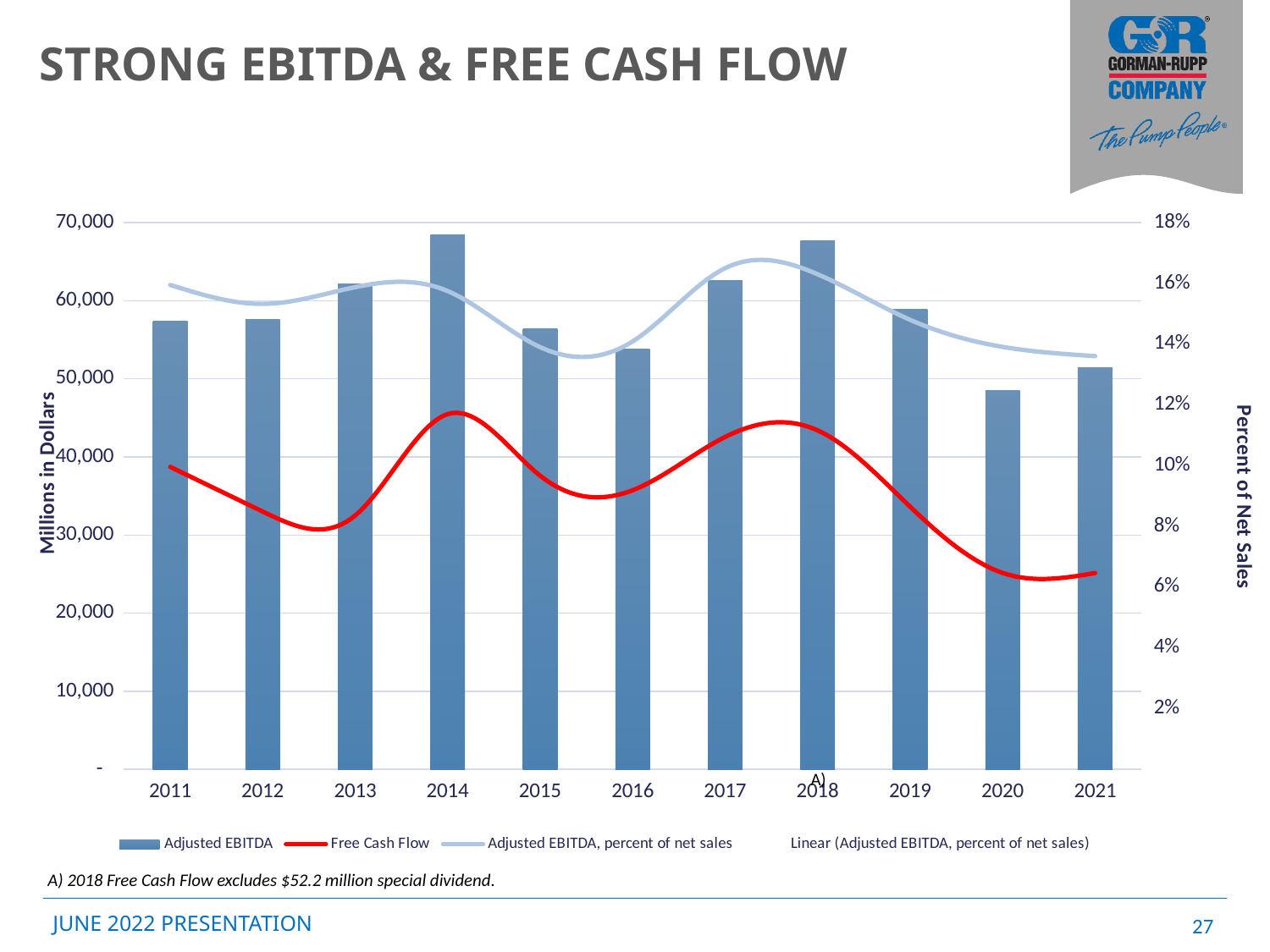
Is the Adjusted EBITDA value for 2020 greater or less than 50,000? less How many years are shown on the x axis of the chart? 11 Is the Adjusted EBITDA, percent of net sales value for 2015 greater or less than 16%? less Does Free Cash Flow rise or fall from 2018 to 2020? Fall Is the Adjusted EBITDA value for 2014 greater or less than 60,000? greater What is the title of the right-hand vertical axis? Percent of Net Sales What kind of chart is shown on the slide? Bar and line chart Which year has the larger Adjusted EBITDA bar, 2013 or 2016? 2013 Which year has the lowest Adjusted EBITDA bar? 2020 How many entries does the chart's legend list? 4